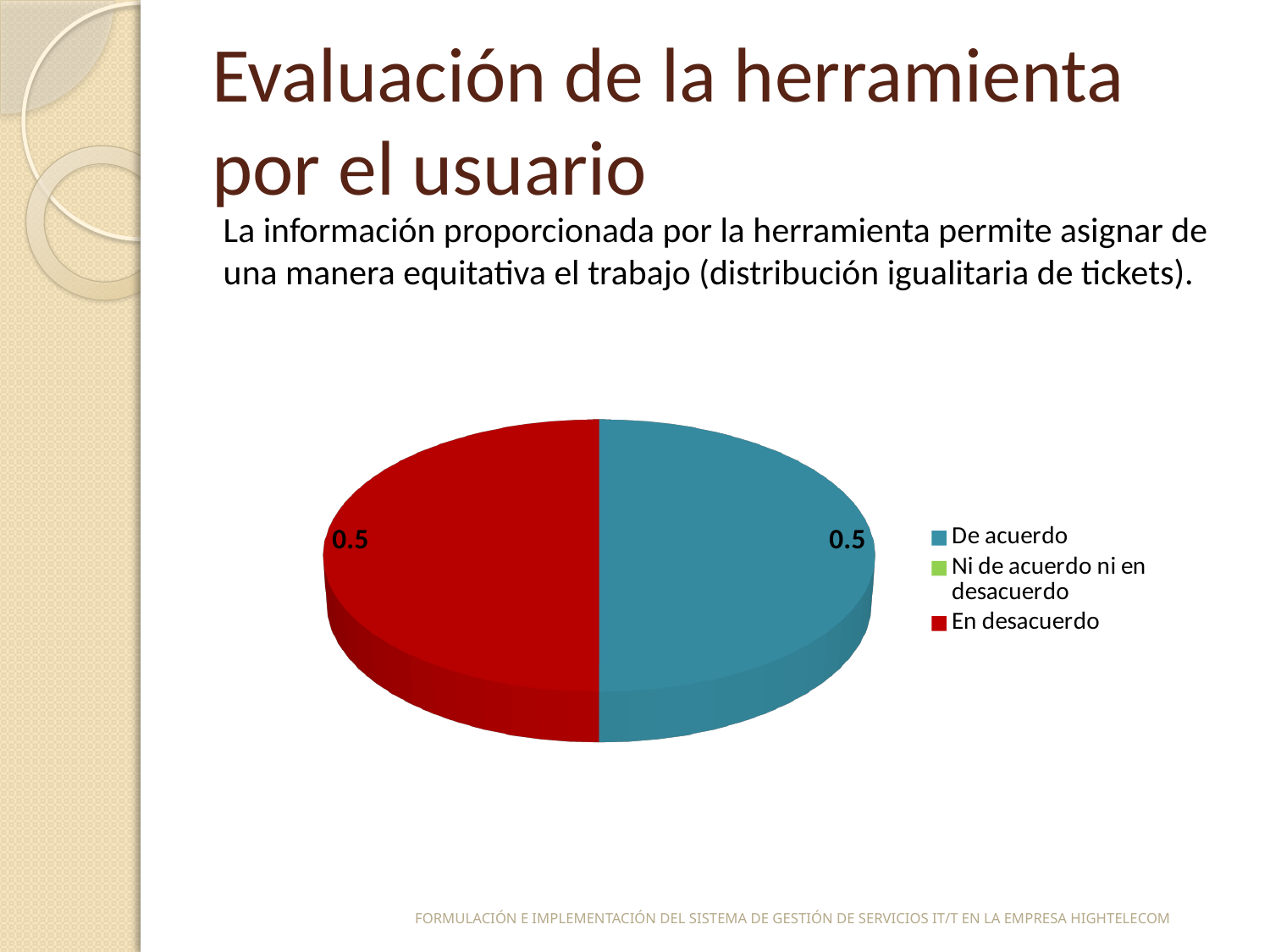
What share of the pie does the "De acuerdo" slice represent? 50% What kind of chart is shown on the slide? pie chart Is the value for "De acuerdo" larger than, smaller than, or equal to the value for "En desacuerdo"? equal Which legend entry has no visible slice in the pie chart? Ni de acuerdo ni en desacuerdo What is the total of the values printed on the pie chart? 1 What is the value shown for the "En desacuerdo" slice? 0.5 How many slices are visible in the pie chart? 2 What is the difference between the values for "De acuerdo" and "En desacuerdo"? 0 How many entries does the legend list? 3 What colour is the "En desacuerdo" slice? red What is the value shown for the "De acuerdo" slice? 0.5